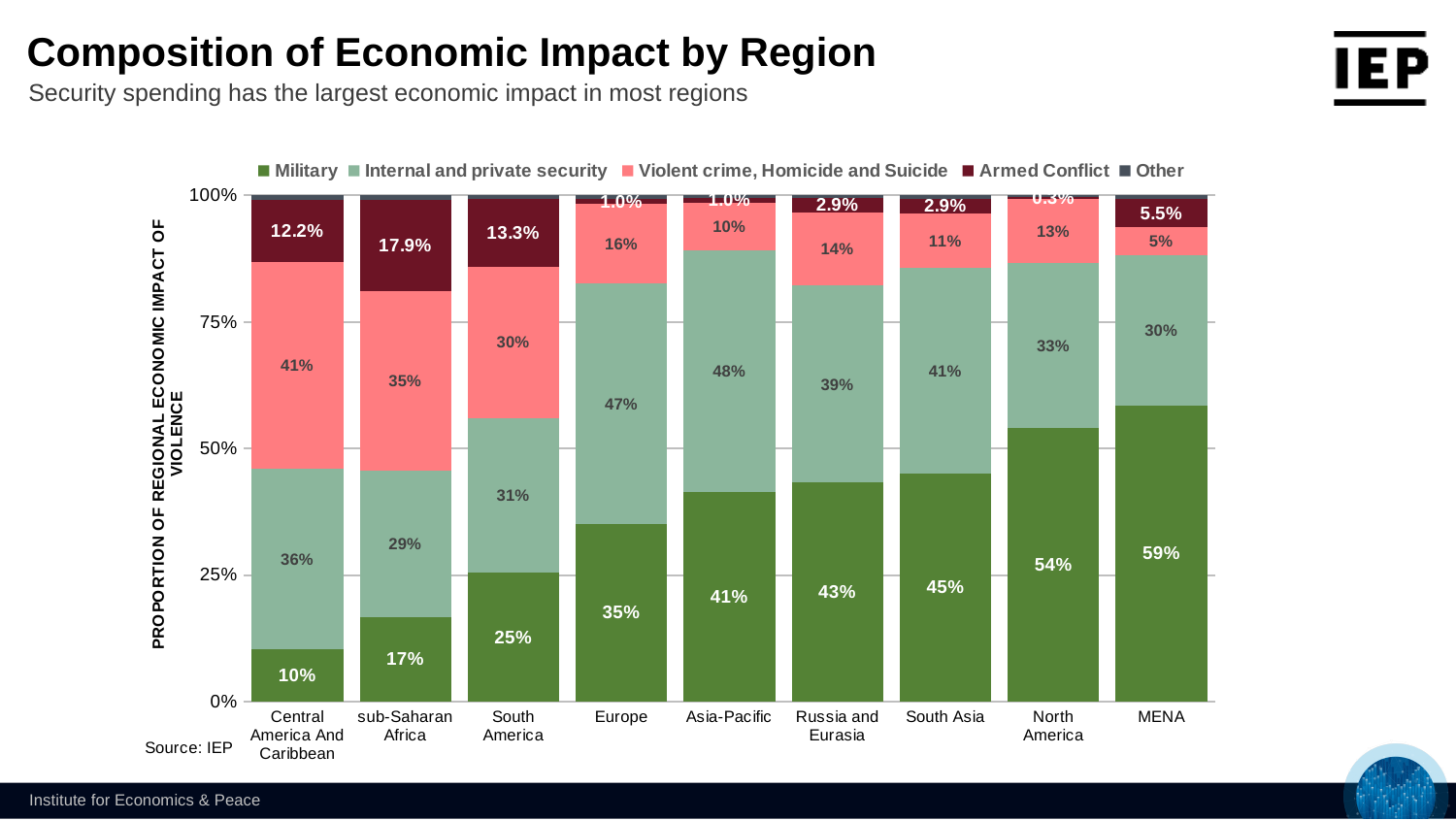
Which region has the highest Military share? MENA How many regions are shown on the x axis? 9 What kind of chart is shown on the slide? Stacked bar chart Which is larger, the Internal and private security share for Asia-Pacific or for North America? Asia-Pacific What is the difference in percentage points between the Military share for MENA and for Central America And Caribbean? 49 percentage points What is the Violent crime, Homicide and Suicide share for Central America And Caribbean? 41% Does the Military share rise or fall moving from left to right across the regions? Rise What is the Military share for MENA? 59% What is the Armed Conflict share for sub-Saharan Africa? 17.9% Which region has the lowest Military share? Central America And Caribbean How many series does the legend list? 5 What is the Internal and private security share for Europe? 47%